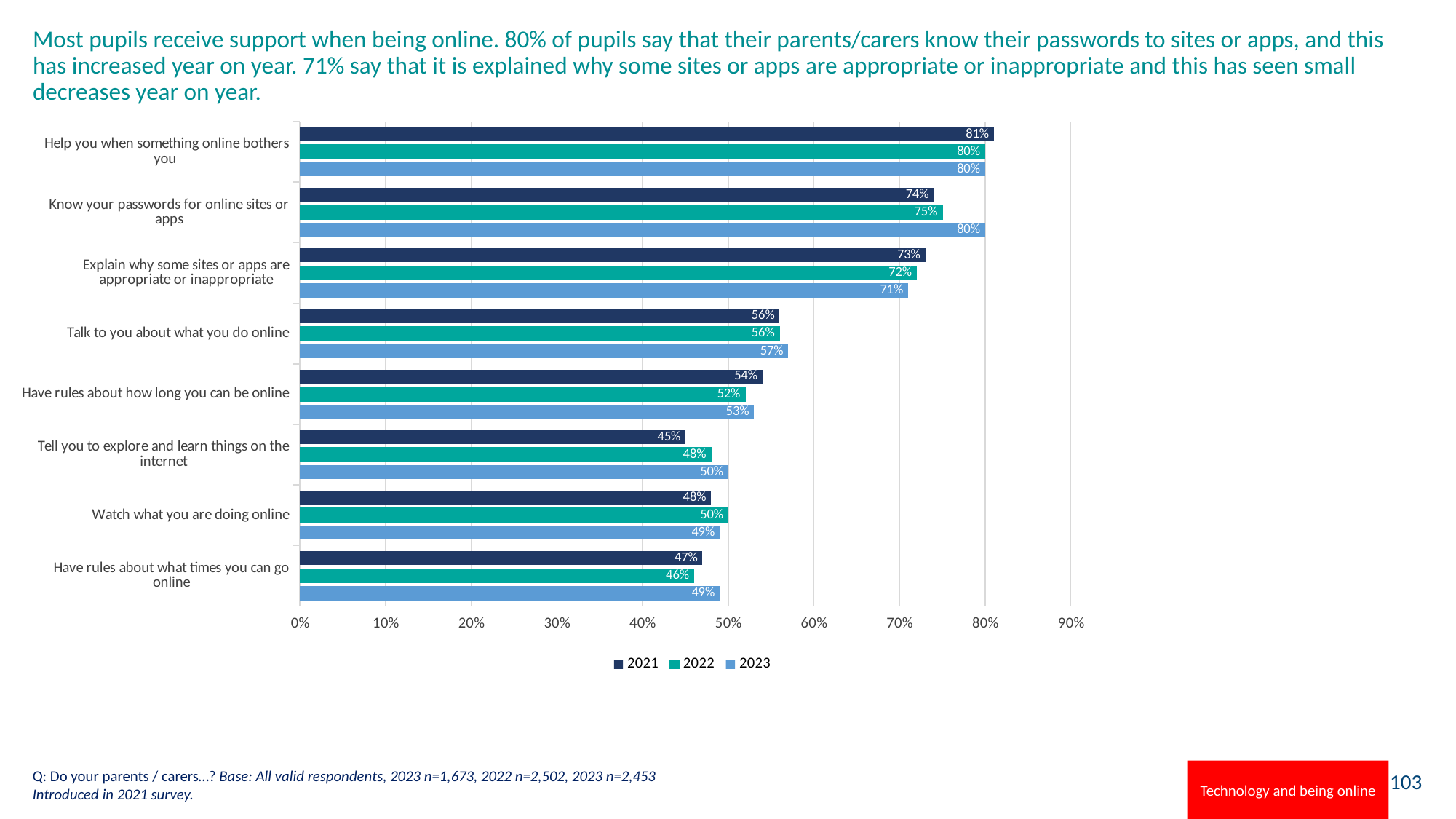
How many categories are shown on the chart? 8 What is the 2021 value for 'Tell you to explore and learn things on the internet'? 45% Do the values for 'Explain why some sites or apps are appropriate or inappropriate' rise or fall from 2021 to 2023? Fall What is the 2022 value for 'Have rules about what times you can go online'? 46% Which is larger: the 2022 value for 'Watch what you are doing online' or the 2022 value for 'Tell you to explore and learn things on the internet'? Watch what you are doing online Which years are listed in the chart legend? 2021, 2022, 2023 How many series does the legend list? 3 What is the 2023 value for 'Know your passwords for online sites or apps'? 80% Which category has the highest 2021 value? Help you when something online bothers you What kind of chart is shown on the slide? Bar chart What is the difference between the 2023 and 2021 values for 'Know your passwords for online sites or apps'? 6%